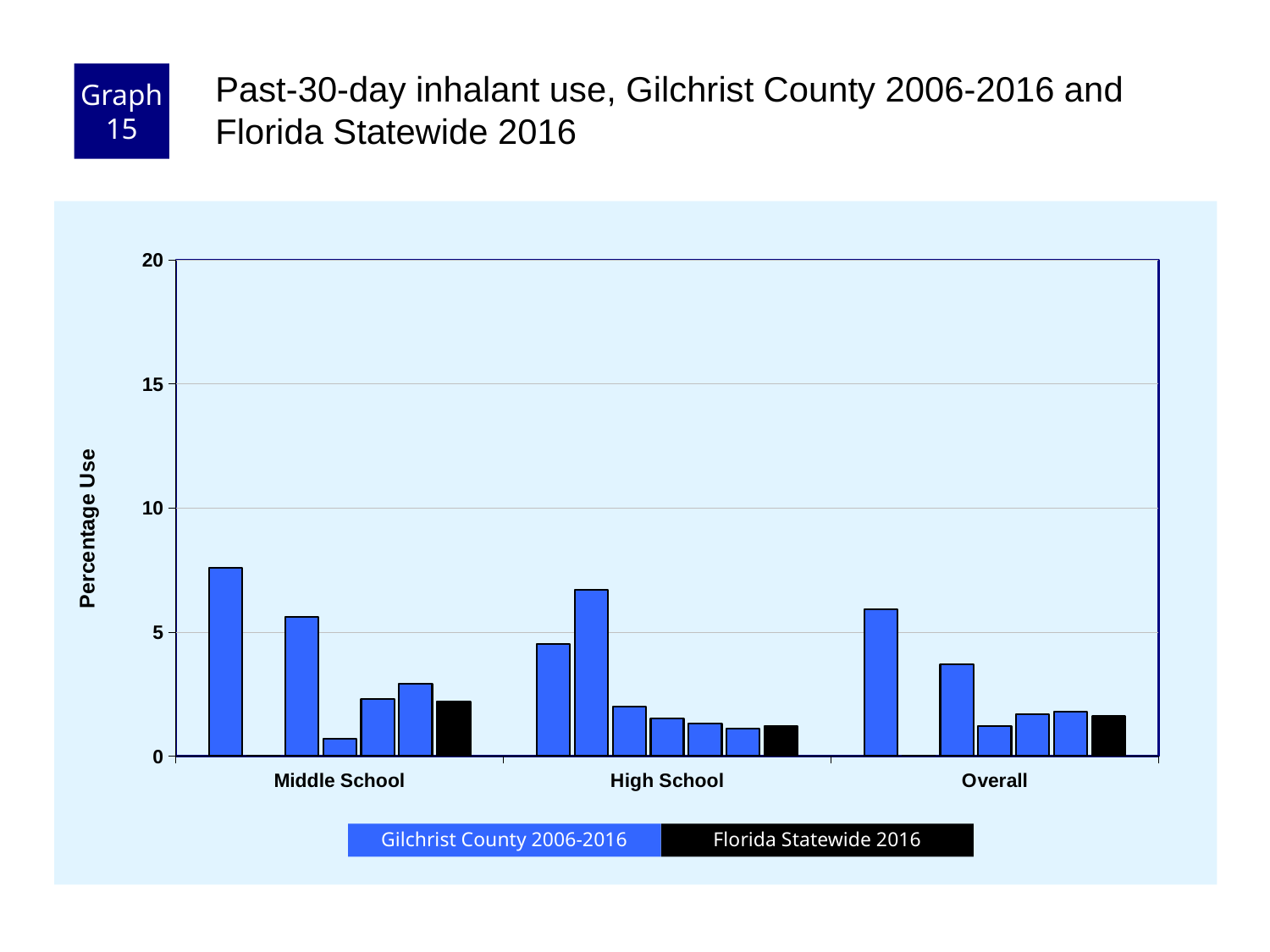
What kind of chart is shown on the slide? bar chart Is the value of the tallest Middle School bar greater or less than 5? greater How many categories are shown on the x axis? 3 Which category group contains the shortest bar on the chart? Middle School Is the Florida Statewide 2016 value for High School greater or less than 5? less Is the Florida Statewide 2016 value for Middle School greater or less than 5? less Which series is shown in black in the legend? Florida Statewide 2016 How many series does the legend list? 2 Is the Florida Statewide 2016 value larger for Middle School or for High School? Middle School Which category group contains the tallest bar on the chart? Middle School What is the label of the y axis? Percentage Use